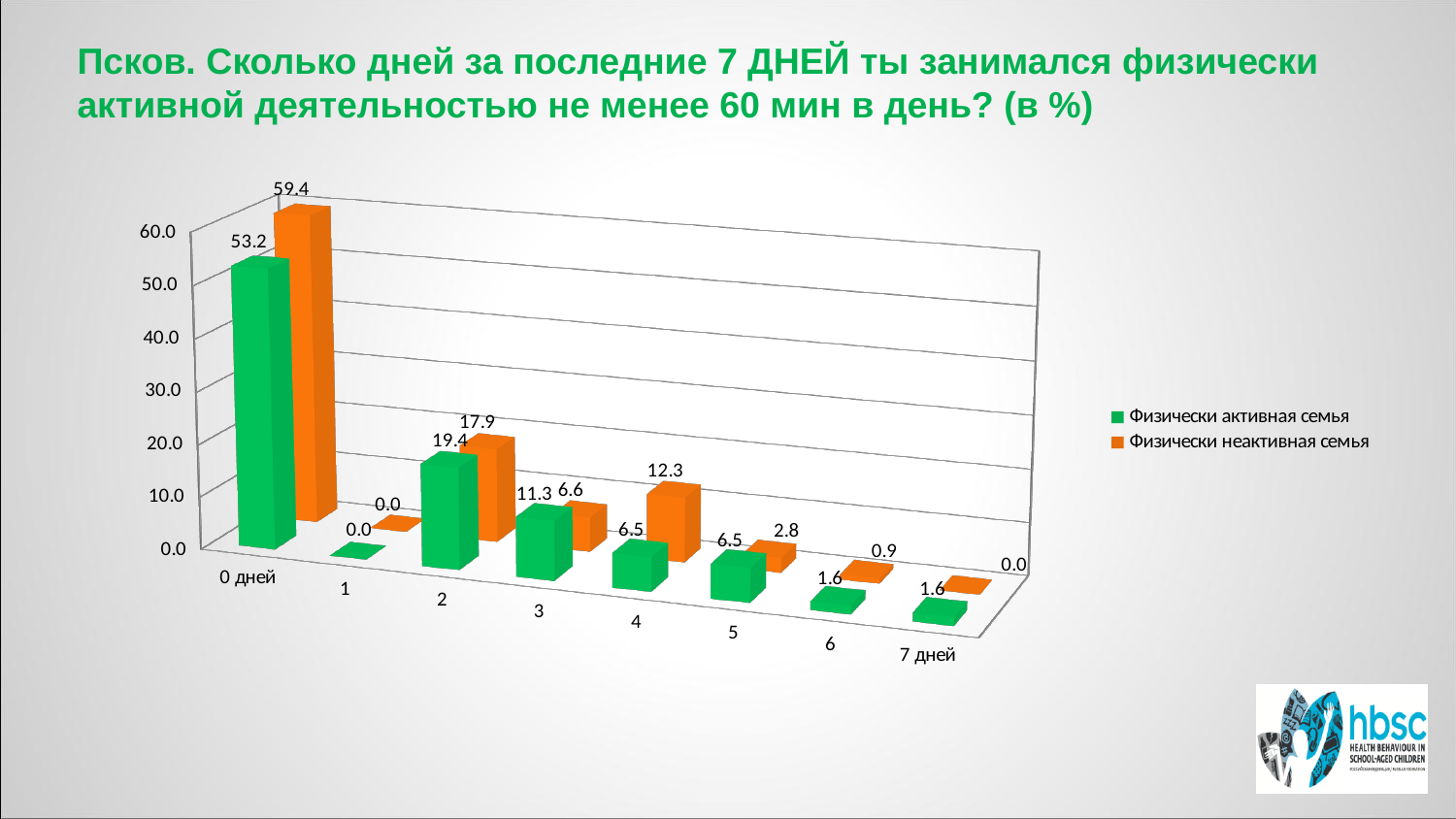
What value is shown for 'Физически активная семья' at '0 дней'? 53.2 What value is shown for 'Физически неактивная семья' at '0 дней'? 59.4 Which category has the highest value for 'Физически неактивная семья'? 0 дней At category '5', which series has the larger value: 'Физически активная семья' or 'Физически неактивная семья'? Физически активная семья What value is shown for 'Физически неактивная семья' at category '4'? 12.3 How many categories are shown on the x axis? 8 How many series does the legend list? 2 What colour represents 'Физически неактивная семья' in the chart? Orange What value is shown for 'Физически активная семья' at category '3'? 11.3 What is the difference between the 'Физически неактивная семья' and 'Физически активная семья' values at '0 дней'? 6.2 What kind of chart is shown on the slide? Bar chart At category '4', which series has the larger value: 'Физически активная семья' or 'Физически неактивная семья'? Физически неактивная семья